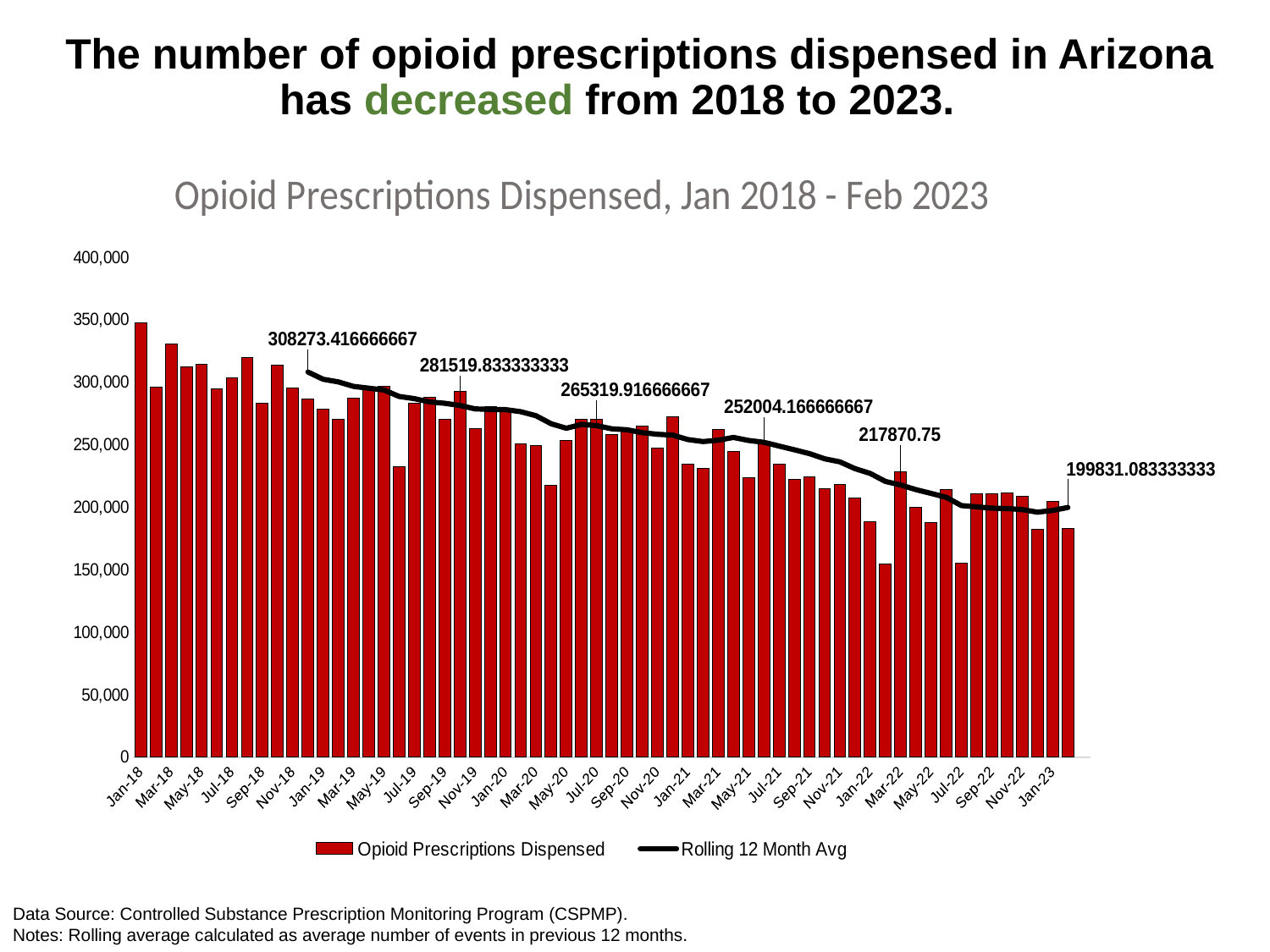
What is the title of the chart? Opioid Prescriptions Dispensed, Jan 2018 - Feb 2023 How many data labels are printed on the Rolling 12 Month Avg line? 6 Is the last Opioid Prescriptions Dispensed bar (Feb 2023) greater or less than 200,000? less Is the Opioid Prescriptions Dispensed bar for Jan-18 greater or less than 300,000? greater What is the last labeled value on the Rolling 12 Month Avg line? 199831.083333333 Which labeled value on the Rolling 12 Month Avg line is the lowest? 199831.083333333 What are the two series named in the legend? Opioid Prescriptions Dispensed; Rolling 12 Month Avg What kind of chart is shown on the slide? Bar chart with a line overlay What is the first labeled value on the Rolling 12 Month Avg line? 308273.416666667 How many series does the chart legend list? 2 Do the Opioid Prescriptions Dispensed values generally rise or fall from Jan-18 to Feb 2023? fall Which labeled value on the Rolling 12 Month Avg line is the highest? 308273.416666667